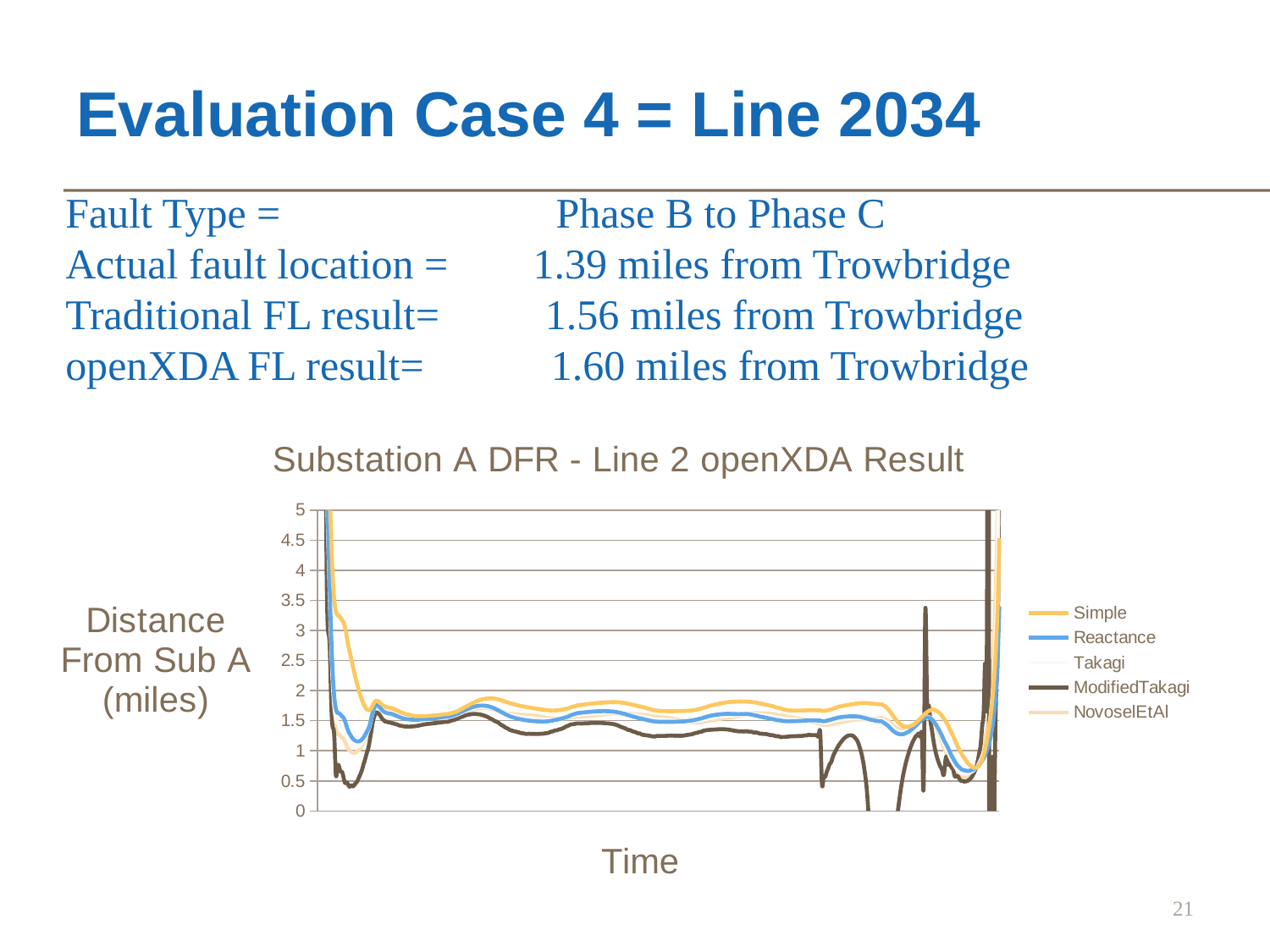
Which series in the legend is drawn in blue? Reactance What is the label of the horizontal axis of the chart? Time What is the highest value shown on the vertical axis of the chart? 5 In the middle of the time range, is the value of the ModifiedTakagi series greater or less than 2? less In the middle of the time range, is the value of the Simple series greater or less than 1.5? greater How many series does the legend of the chart list? 5 What kind of chart is shown on the slide? line chart In the middle of the time range, which series is higher, Simple or ModifiedTakagi? Simple